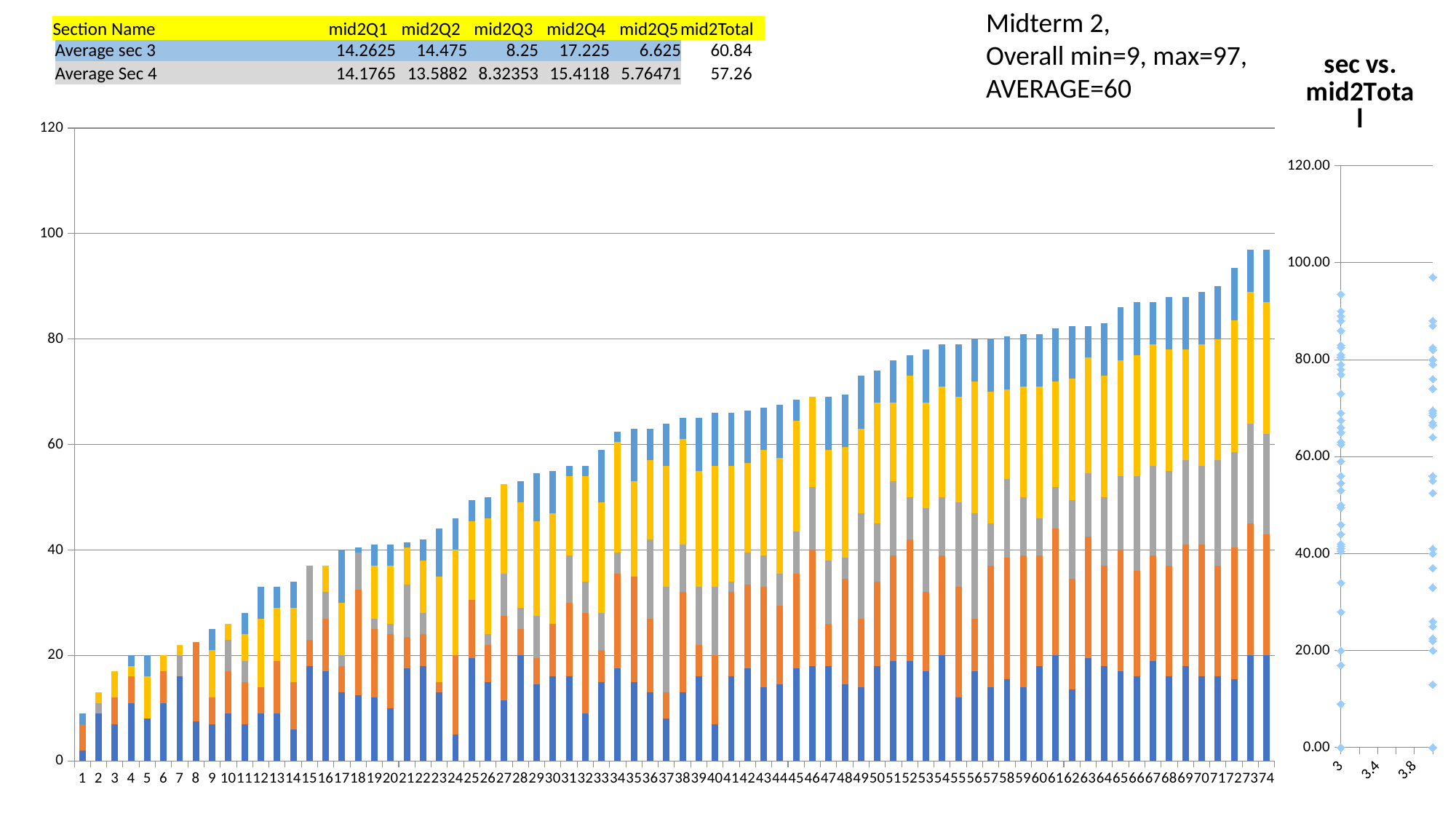
What is the title of the scatter chart on the right of the slide? sec vs. mid2Total What kind of chart is the large chart on the left of the slide? stacked bar chart In the large stacked bar chart, do the bar totals rise or fall from left to right along the x axis? rise In the large stacked bar chart, is the total for category 1 greater or less than 20? less In the large stacked bar chart, how many bars (categories) are plotted along the x axis? 74 In the large stacked bar chart, which category has the lowest total? 1 In the large stacked bar chart, which has the larger total, category 60 or category 30? category 60 What is the highest value shown on the y axis of the large stacked bar chart? 120 In the large stacked bar chart, is the total for category 74 greater or less than 80? greater What kind of chart is the small chart titled "sec vs. mid2Total" on the right? scatter chart In the large stacked bar chart, is the total for category 40 greater or less than 60? greater